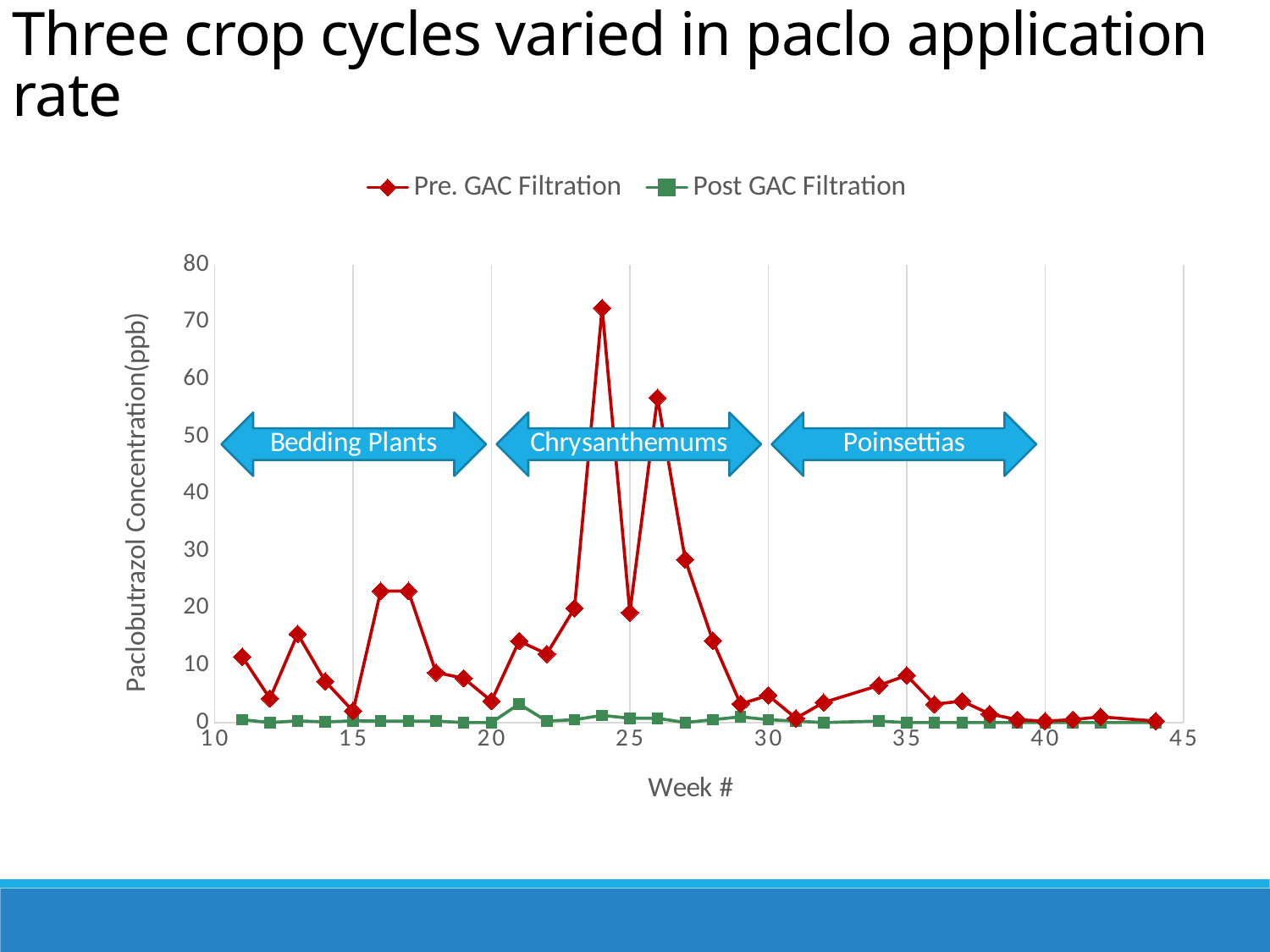
What is the title of the y axis? Paclobutrazol Concentration(ppb) What kind of chart is shown on the slide? line chart Is the Pre. GAC Filtration value at week 15 greater or less than 10? less Does the Pre. GAC Filtration series rise or fall from week 26 to week 31? fall How many series does the legend list? 2 At week 24, which series has the larger value: Pre. GAC Filtration or Post GAC Filtration? Pre. GAC Filtration Which is larger for Pre. GAC Filtration: the value at week 24 or the value at week 26? week 24 What are the two series named in the legend? Pre. GAC Filtration and Post GAC Filtration At which week does the Pre. GAC Filtration series reach its highest value? Week 24 Is the Pre. GAC Filtration value at week 26 greater or less than 50? greater Is the Post GAC Filtration value at week 24 greater or less than 10? less